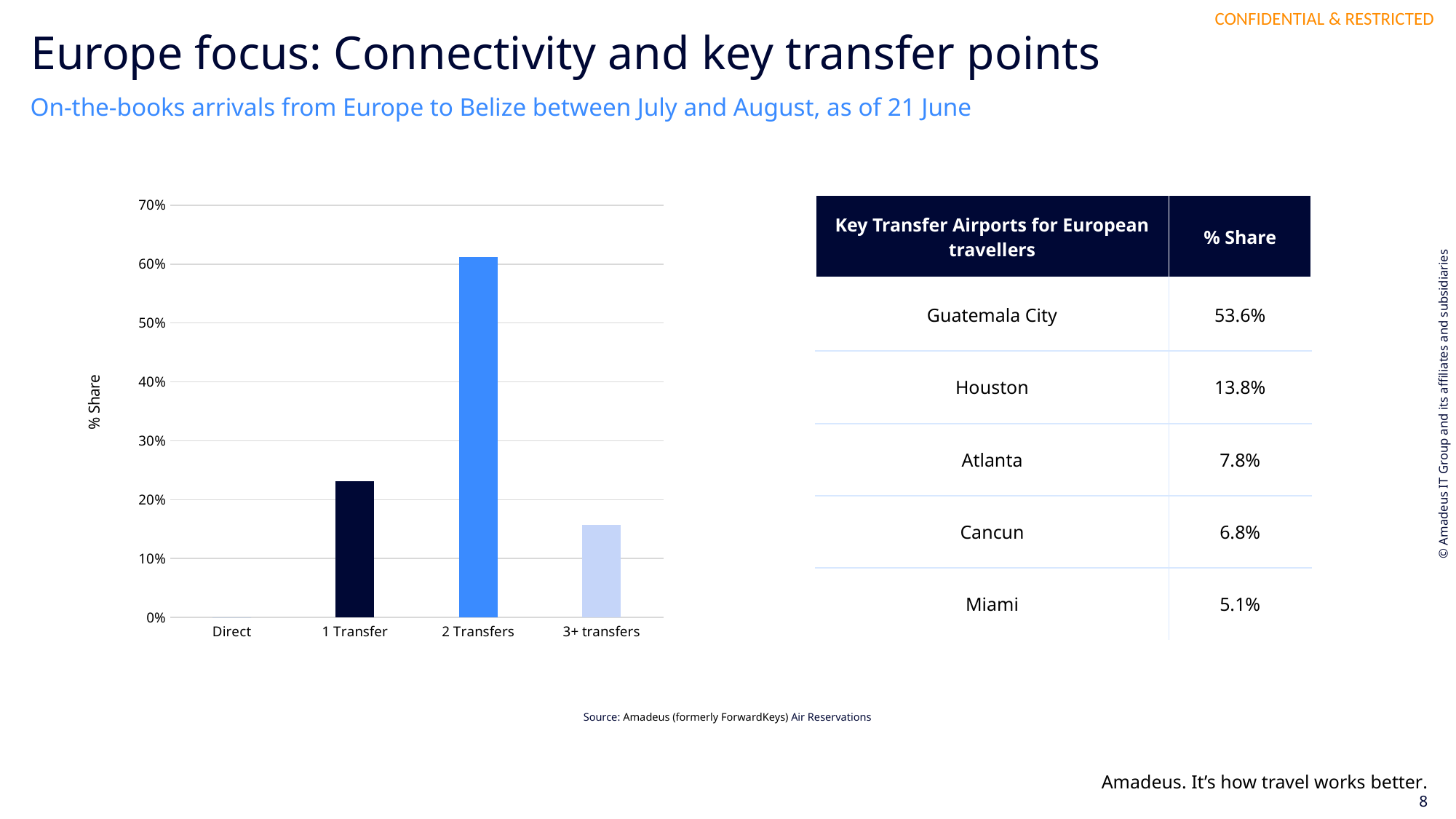
Which category has the lowest bar in the chart? Direct Which is larger, the value for 1 Transfer or the value for 3+ transfers? 1 Transfer Is the value for Direct greater or less than 10%? less What is the highest value shown on the y axis of the chart? 70% Is the value for 3+ transfers greater or less than 20%? less What is the label on the y axis of the chart? % Share How many categories are shown on the x axis of the bar chart? 4 Which is larger, the value for 2 Transfers or the value for 1 Transfer? 2 Transfers Is the value for 2 Transfers greater or less than 60%? greater Which category has the highest bar in the chart? 2 Transfers What kind of chart is shown on the slide? bar chart